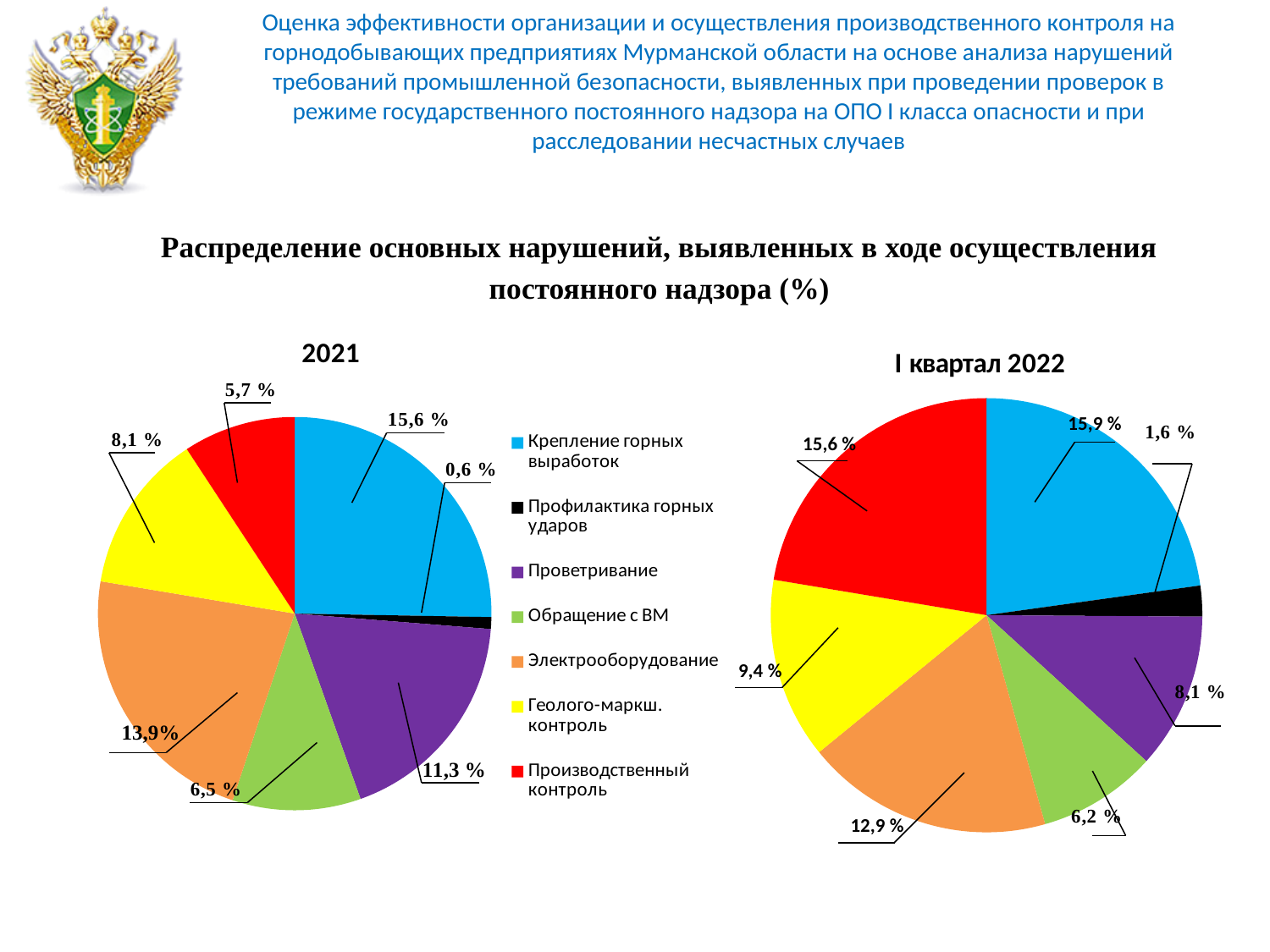
In the 2021 pie chart, which category has the smallest share? Профилактика горных ударов What type of chart is used for the 2021 data? Pie chart In the 2021 pie chart, what is the value for Производственный контроль? 5,7 % In the 2021 pie chart, what is the difference between Электрооборудование and Проветривание? 2,6 % How many slices does the I квартал 2022 pie chart have? 7 In the I квартал 2022 pie chart, what is the value for Геолого-маркш. контроль? 9,4 % In the 2021 pie chart, which category has the largest share? Крепление горных выработок In the I квартал 2022 pie chart, which category has the smallest share? Профилактика горных ударов How many entries does the legend list? 7 In the I квартал 2022 pie chart, what is the value for Электрооборудование? 12,9 % In the 2021 pie chart, which is larger: Геолого-маркш. контроль or Обращение с ВМ? Геолого-маркш. контроль In the 2021 pie chart, what is the value for Крепление горных выработок? 15,6 %